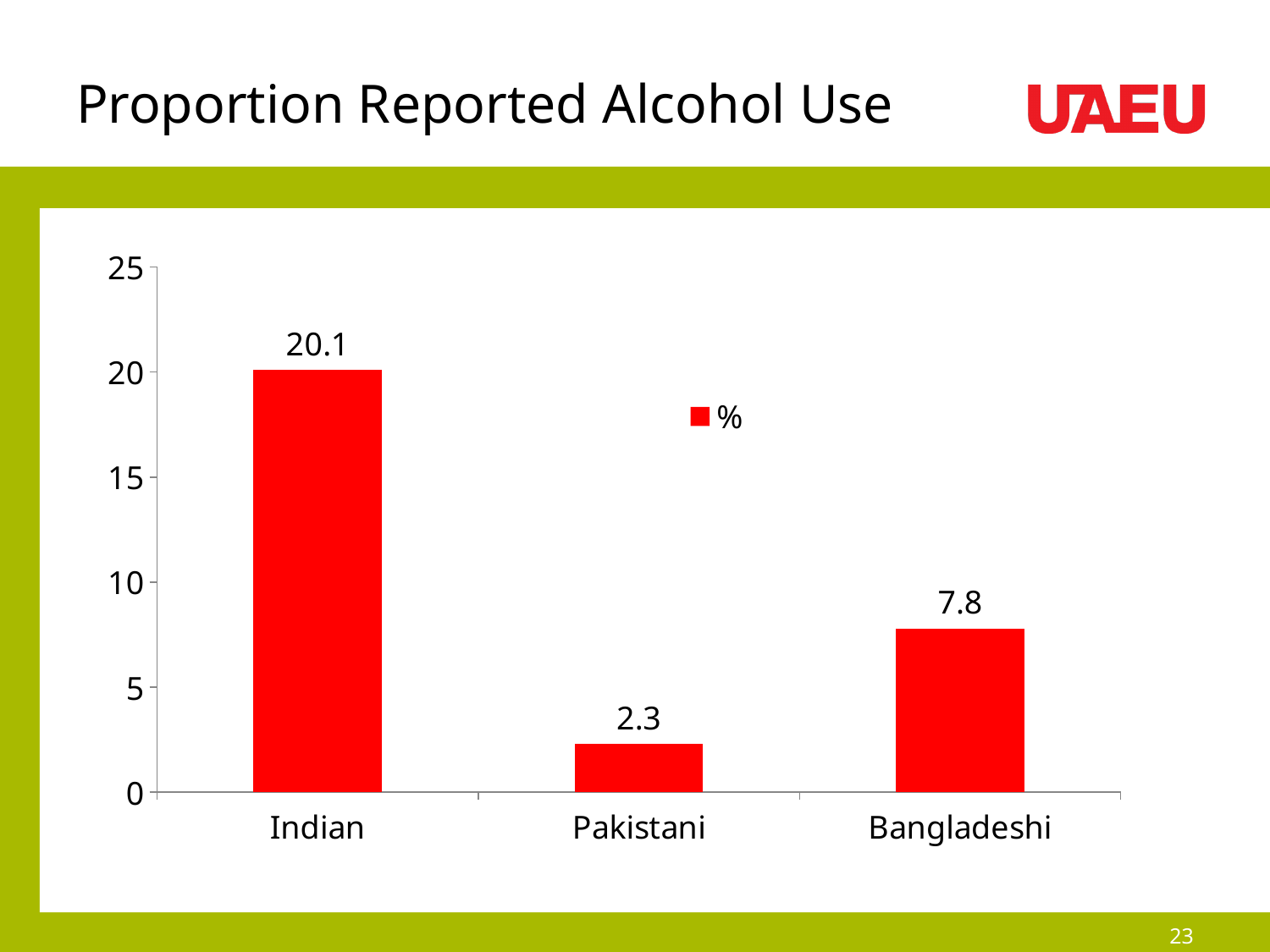
What is the difference between the values for Bangladeshi and Pakistani? 5.5 What is the value for Bangladeshi? 7.8 Is the value for Indian greater or less than 15? greater What is the value for Indian? 20.1 What is the difference between the values for Indian and Bangladeshi? 12.3 How many categories are shown on the x axis? 3 What is the value for Pakistani? 2.3 What is the title of the slide's chart? Proportion Reported Alcohol Use Which is larger, the value for Bangladeshi or the value for Pakistani? Bangladeshi Which category has the lowest value? Pakistani What kind of chart is shown on the slide? Bar chart Which category has the highest value? Indian